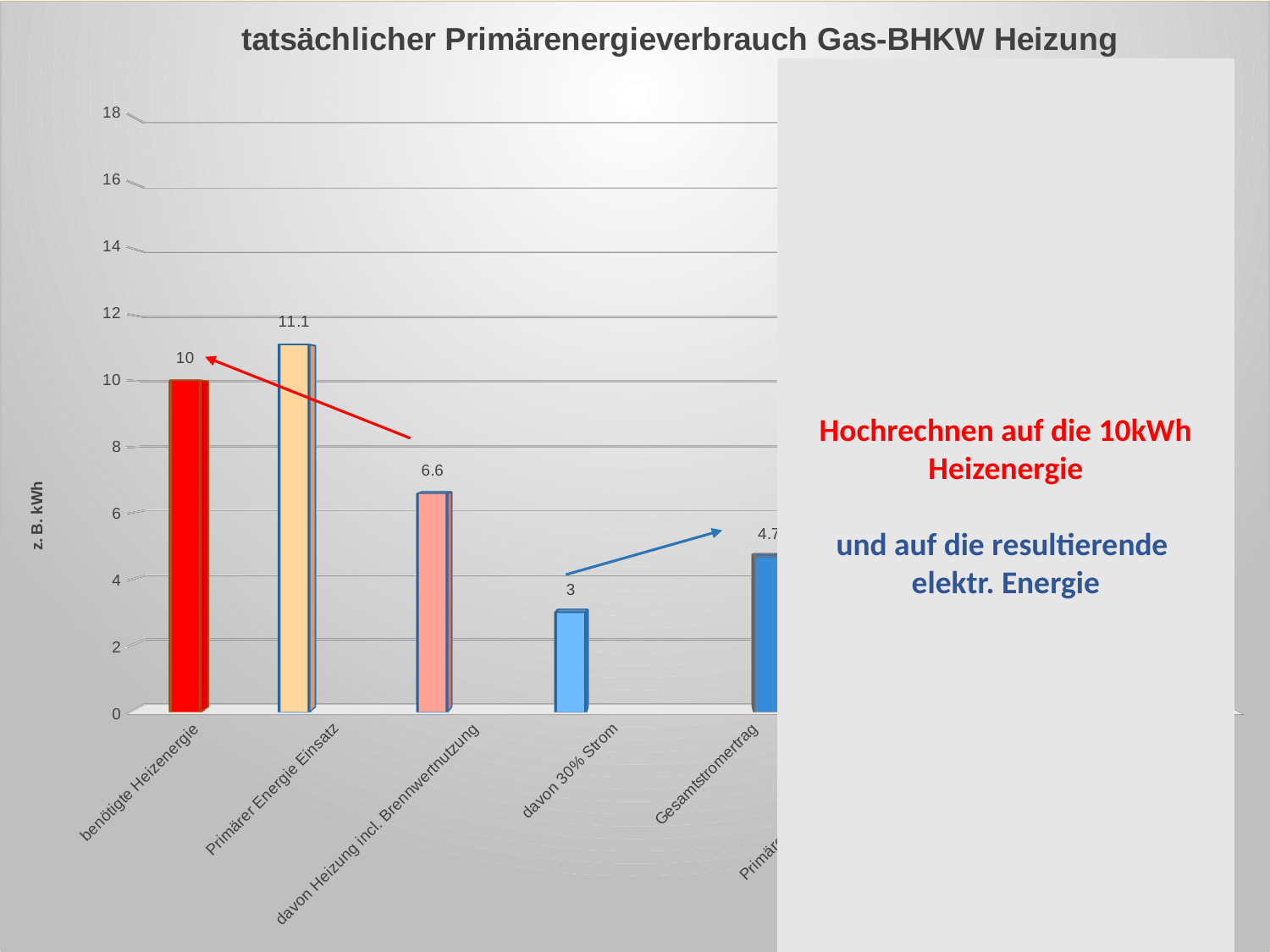
Which is larger, Primärer Energie Einsatz or benötigte Heizenergie? Primärer Energie Einsatz What is the title of the chart? tatsächlicher Primärenergieverbrauch Gas-BHKW Heizung What is the value for Gesamtstromertrag? 4.7 Which is larger, davon 30% Strom or Gesamtstromertrag? Gesamtstromertrag What is the value for Primärer Energie Einsatz? 11.1 What is the value for benötigte Heizenergie? 10 What kind of chart is shown on the slide? bar chart What is the value for davon 30% Strom? 3 What is the difference between davon Heizung incl. Brennwertnutzung and davon 30% Strom? 3.6 What is the difference between Primärer Energie Einsatz and benötigte Heizenergie? 1.1 Is the value for davon Heizung incl. Brennwertnutzung greater or less than 8? less What is the value for davon Heizung incl. Brennwertnutzung? 6.6